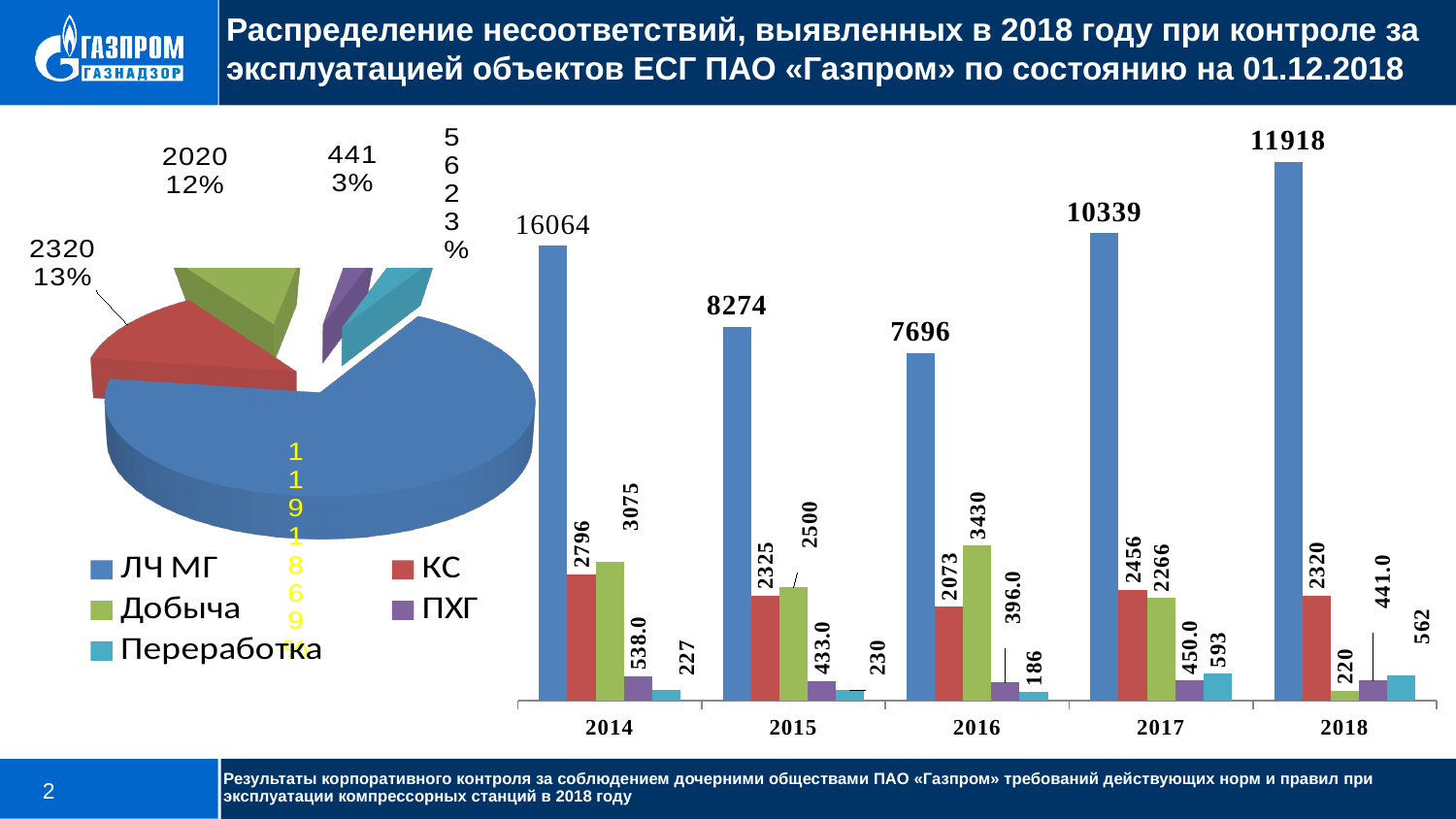
On the bar chart on the right, what is the value of the tallest (blue) bar for 2014? 16064 On the pie chart on the left, what share does the ЛЧ МГ slice have? 69% On the bar chart on the right, how many years are shown on the x axis? 5 On the bar chart on the right, what is the value of the tallest (blue) bar for 2018? 11918 On the pie chart on the left, what value and share are shown for the КС slice? 2320, 13% How many entries does the legend of the pie chart on the left list? 5 On the bar chart on the right, which is larger: the red bar for 2014 or the red bar for 2015? 2014 On the bar chart on the right, what is the value of the green bar for 2016? 3430 What type of chart is shown on the right side of the slide? Bar chart On the bar chart on the right, which year has the lowest blue bar? 2016 On the bar chart on the right, what is the difference between the blue bar values for 2017 and 2016? 2643